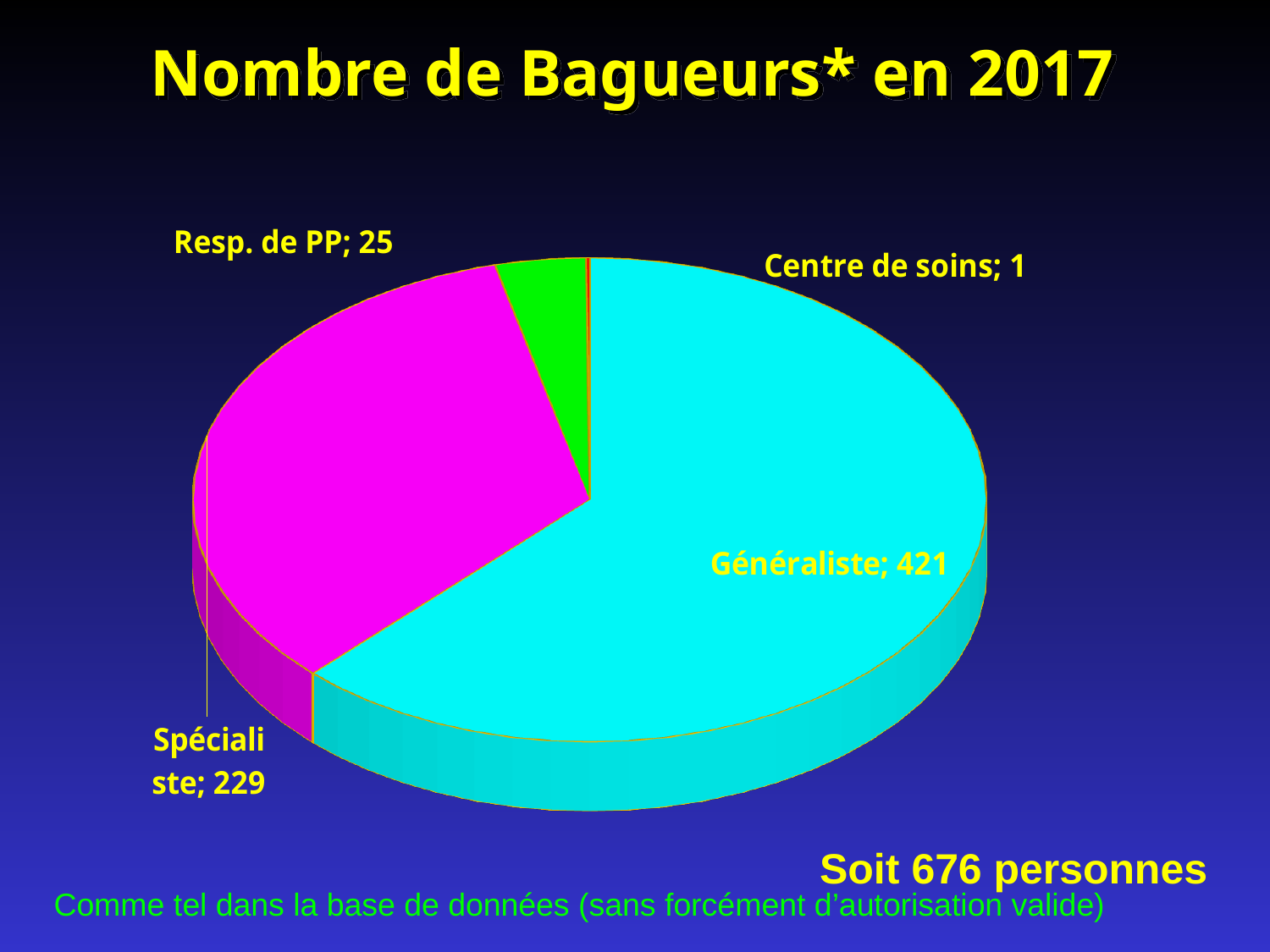
What is the difference between the values for Généraliste and Spécialiste? 192 What is the value for Centre de soins? 1 Which is larger, Resp. de PP or Centre de soins? Resp. de PP What is the title of the chart? Nombre de Bagueurs* en 2017 What is the value for Resp. de PP? 25 What is the value for Généraliste? 421 Which category has the smallest slice? Centre de soins Which category has the largest slice? Généraliste What type of chart is shown on the slide? Pie chart What is the value for Spécialiste? 229 What is the total number of people represented by the pie chart? 676 How many slices does the pie chart have? 4